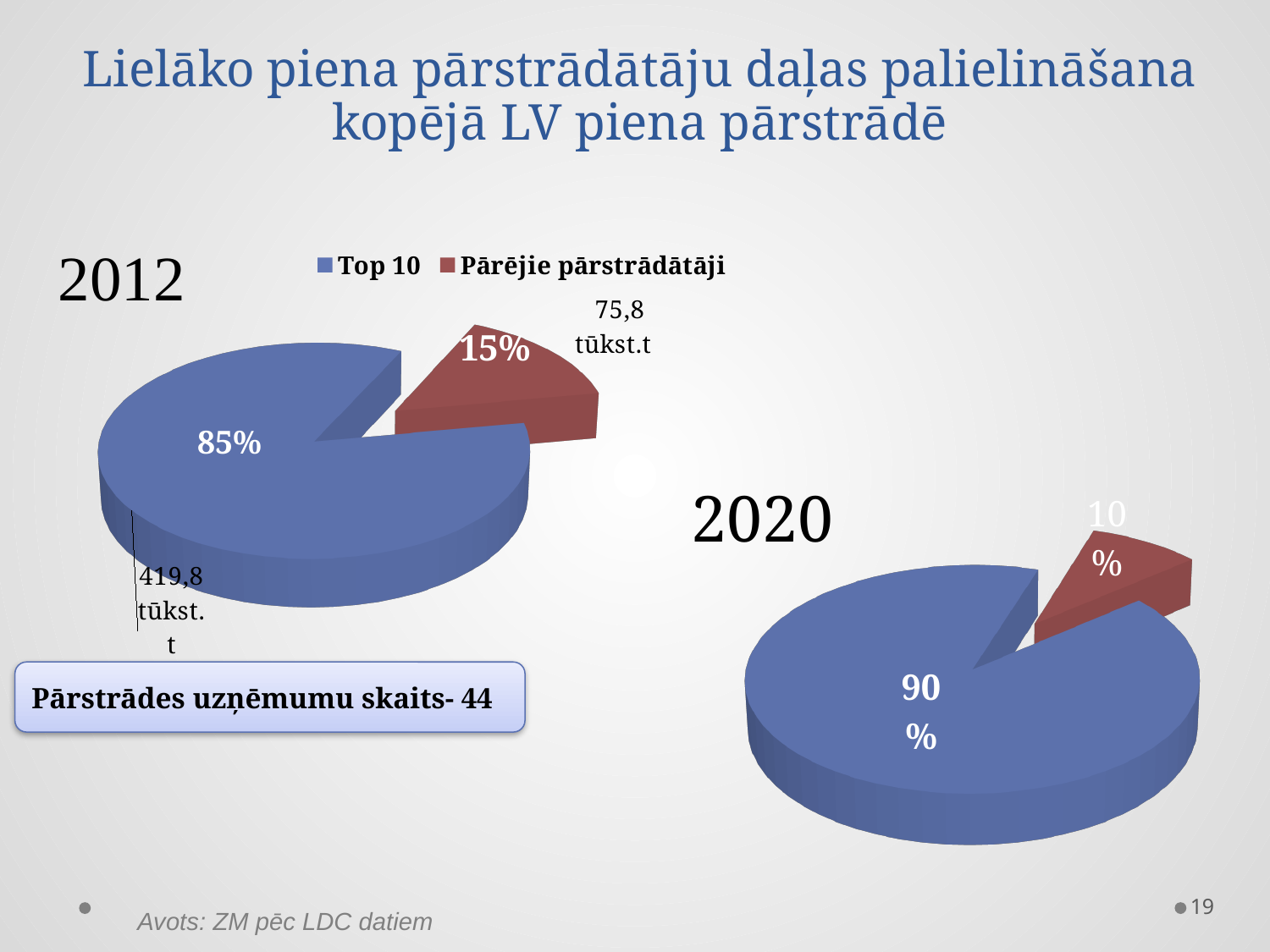
In the 2012 pie chart, what share does Top 10 hold? 85% In the 2012 pie chart, what volume in tūkst.t is labelled for Pārējie pārstrādātāji? 75,8 tūkst.t What kind of chart is used for the 2012 data on the slide? pie chart What is the difference in percentage points between the Top 10 share in 2020 and in 2012? 5 percentage points In the 2020 pie chart, which slice is the smallest? Pārējie pārstrādātāji In the 2012 pie chart, what share does Pārējie pārstrādātāji hold? 15% In the 2020 pie chart, what share does Pārējie pārstrādātāji hold? 10% In the 2012 pie chart, what volume in tūkst.t is labelled for Top 10? 419,8 tūkst.t How many slices does each pie chart on the slide have? 2 In the 2012 pie chart, which slice is the largest? Top 10 How many entries does the legend list? 2